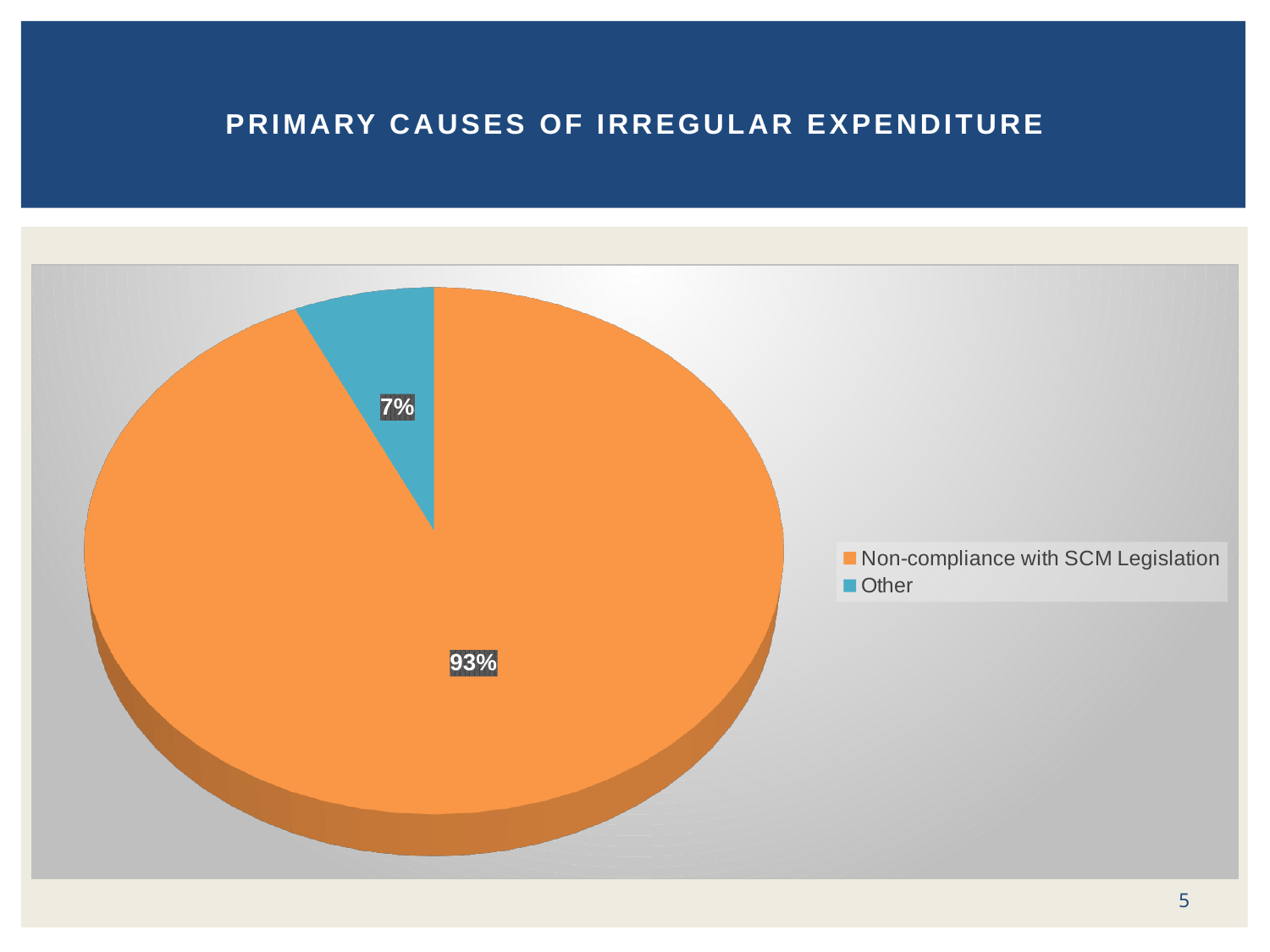
What is the difference in percentage points between Non-compliance with SCM Legislation and Other? 86 Which is larger: the share for Non-compliance with SCM Legislation or the share for Other? Non-compliance with SCM Legislation What share of the pie does the Non-compliance with SCM Legislation slice represent? 93% What percentage of irregular expenditure is attributed to Other? 7% What kind of chart is shown on the slide? Pie chart How many categories does the pie chart show? 2 What colour is the slice for Other? Blue Which category has the smallest share of the pie? Other How many entries does the legend list? 2 What percentage of irregular expenditure is attributed to Non-compliance with SCM Legislation? 93% What is the title of the slide containing the chart? Primary Causes of Irregular Expenditure Which category has the largest share of the pie? Non-compliance with SCM Legislation